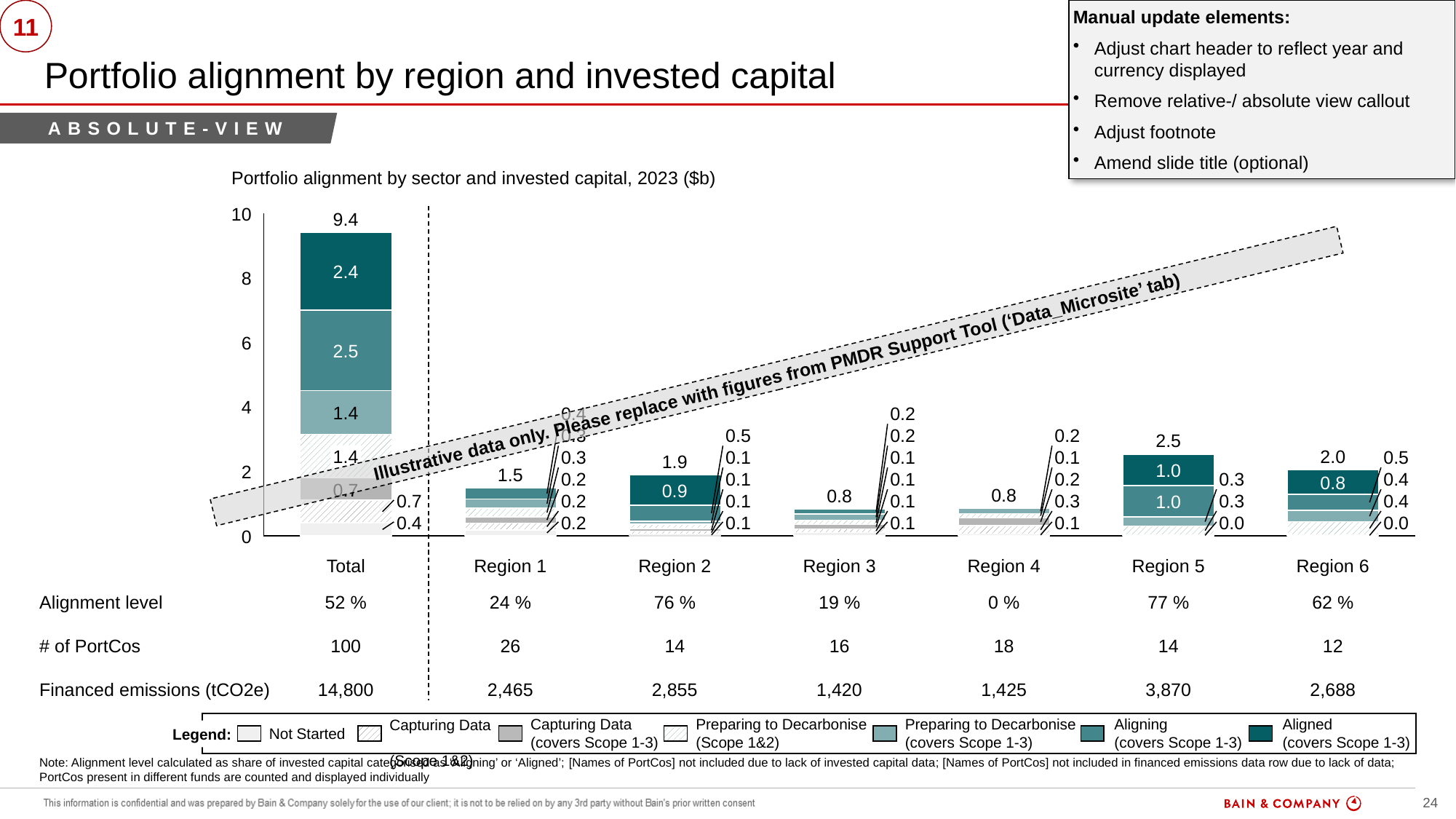
What kind of chart is shown on the slide? Stacked bar chart How many bars (categories) are shown along the x axis of the chart? 7 What is the total value labelled above the 'Total' bar? 9.4 Is the total for the 'Total' bar greater or less than 8? greater What is the difference between the total for Region 5 and the total for Region 2? 0.6 Which has a larger total, Region 1 or Region 2? Region 2 What is the value of the 'Aligned (covers Scope 1-3)' segment in the Region 2 bar? 0.9 What is the title of the chart? Portfolio alignment by sector and invested capital, 2023 ($b) How many entries does the chart legend list? 7 Among Region 1 to Region 6, which region has the highest total invested capital? Region 5 What is the value of the 'Aligned (covers Scope 1-3)' segment in the 'Total' bar? 2.4 What is the total value labelled above the Region 5 bar? 2.5